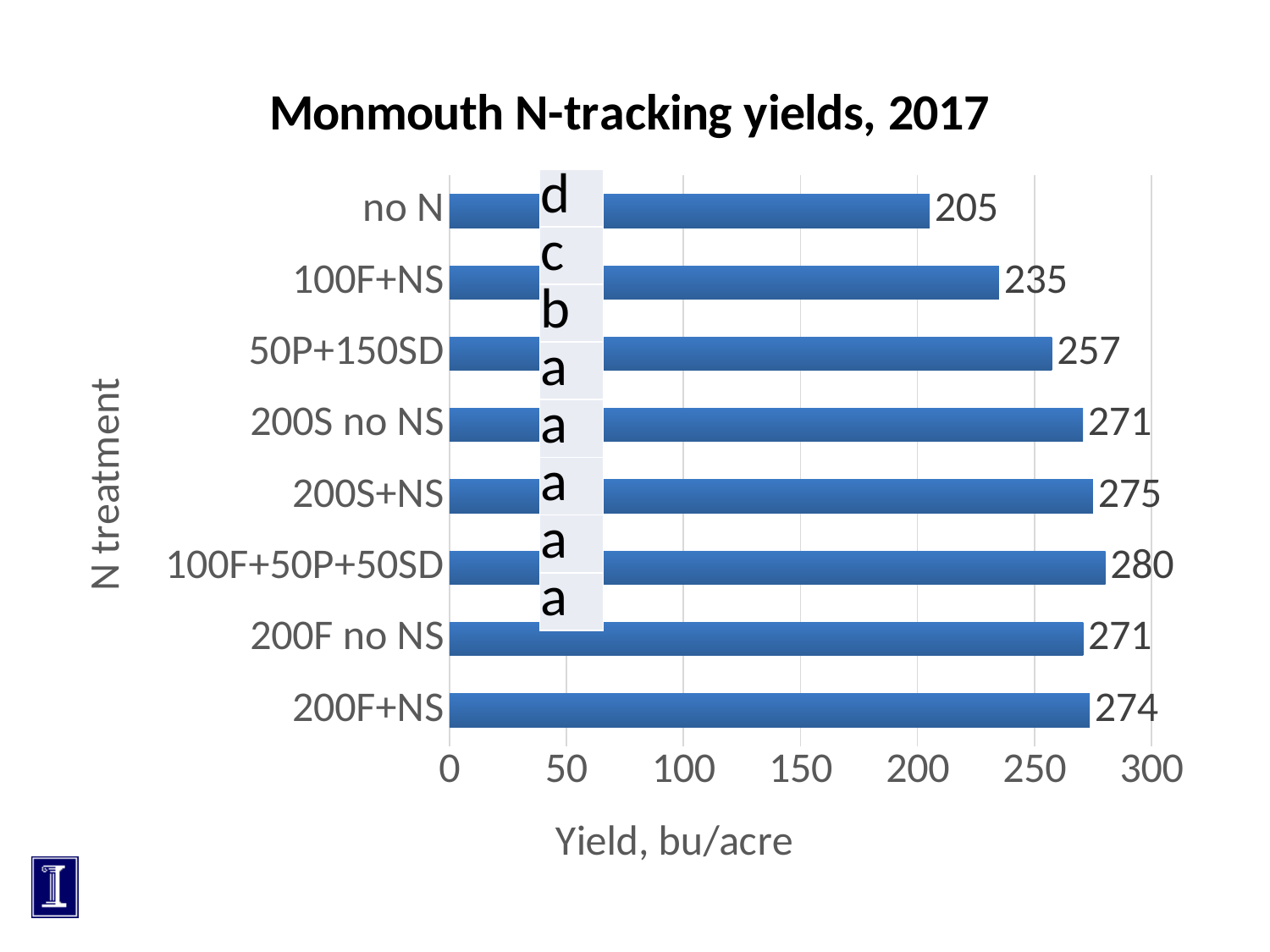
What is the difference in yield between '100F+50P+50SD' and '50P+150SD'? 23 What is the difference in yield between '100F+NS' and 'no N'? 30 What is the yield for the 'no N' treatment? 205 What is the title of the chart? Monmouth N-tracking yields, 2017 What kind of chart is shown on the slide? Bar chart How many N treatments are shown in the chart? 8 What is the yield for the '100F+50P+50SD' treatment? 280 What is the yield for the '200F+NS' treatment? 274 Which N treatment has the lowest yield? no N What is the label of the horizontal axis? Yield, bu/acre Which has a higher yield, '200S+NS' or '50P+150SD'? 200S+NS Which N treatment has the highest yield? 100F+50P+50SD